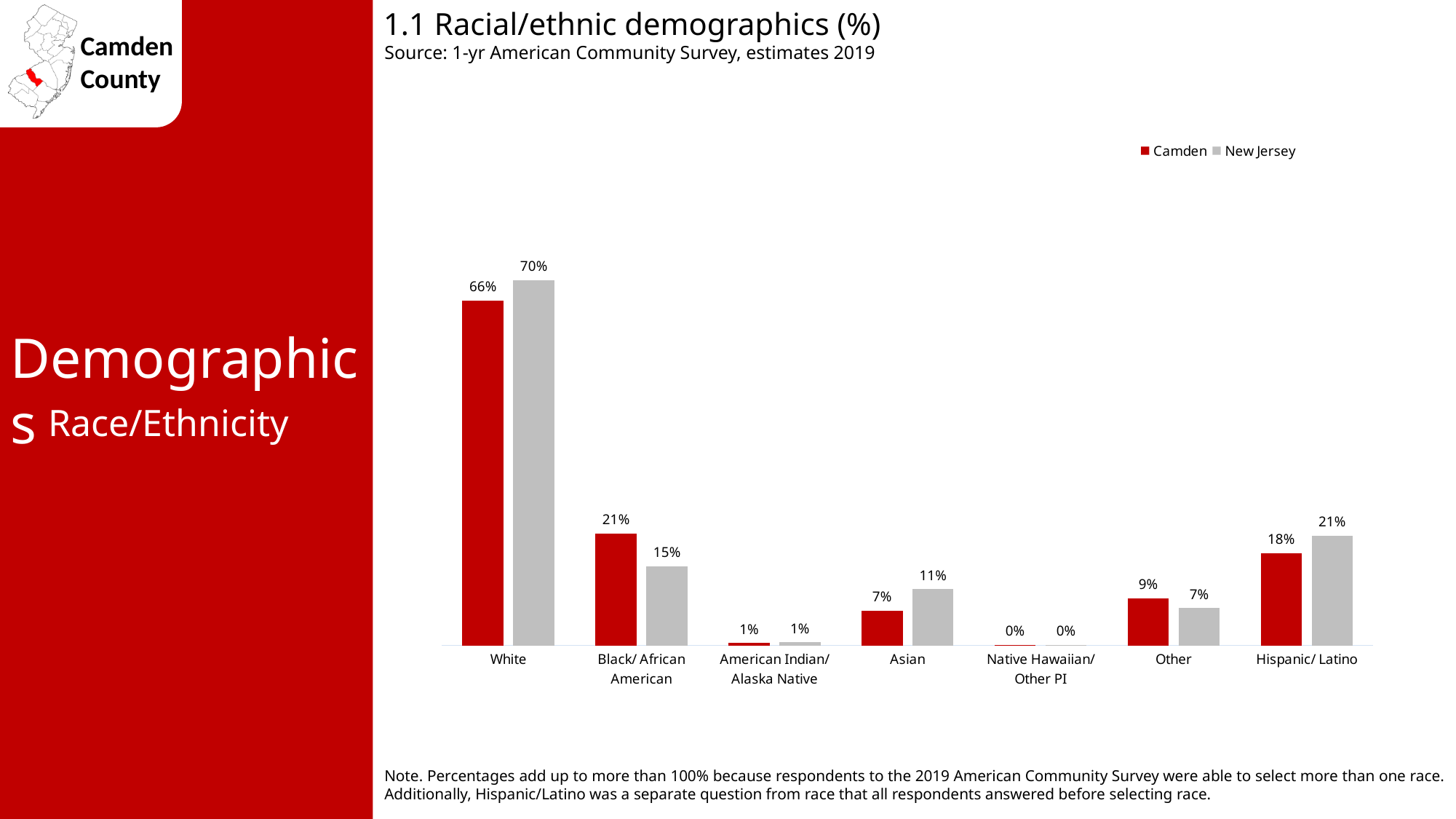
What is the New Jersey value for Asian? 11% What is the difference between the New Jersey and Camden values for White? 4% What is the Camden value for Hispanic/ Latino? 18% How many categories are shown on the x axis? 7 How many series does the legend list? 2 What is the Camden value for White? 66% Which is larger for Asian, the Camden value or the New Jersey value? New Jersey Which category has the highest Camden value? White What is the difference between the Camden and New Jersey values for Black/ African American? 6% Which category has the lowest New Jersey value? Native Hawaiian/ Other PI What kind of chart is shown on the slide? Bar chart What is the New Jersey value for Black/ African American? 15%